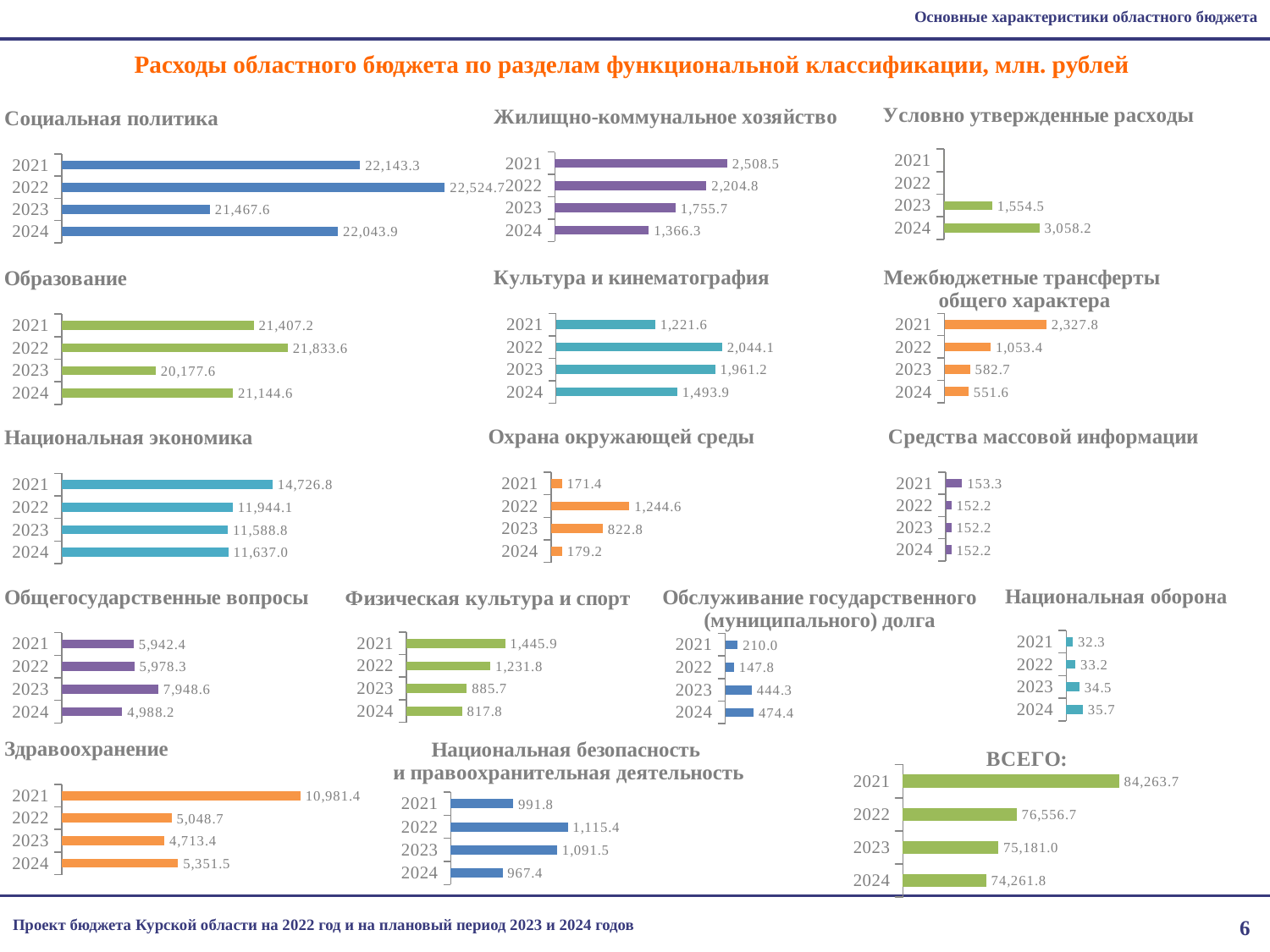
What kind of chart is the "Культура и кинематография" chart? bar chart In the "Здравоохранение" chart, what is the difference between the 2021 and 2022 values? 5,932.7 In the "ВСЕГО:" chart, what is the difference between the 2021 and 2022 values? 7,707.0 In the "Национальная оборона" chart, which year has the lowest value? 2021 How many years are shown in the "Национальная экономика" chart? 4 In the "Жилищно-коммунальное хозяйство" chart, do the values rise or fall from 2021 to 2024? fall In the "Общегосударственные вопросы" chart, which is larger: the value for 2023 or the value for 2024? 2023 In the "Социальная политика" chart, which year has the highest value? 2022 In the "Межбюджетные трансферты общего характера" chart, which year has the highest value? 2021 In the "Условно утвержденные расходы" chart, what is the value for 2024? 3,058.2 In the "Охрана окружающей среды" chart, what is the value for 2022? 1,244.6 In the "ВСЕГО:" chart, what is the value for 2021? 84,263.7